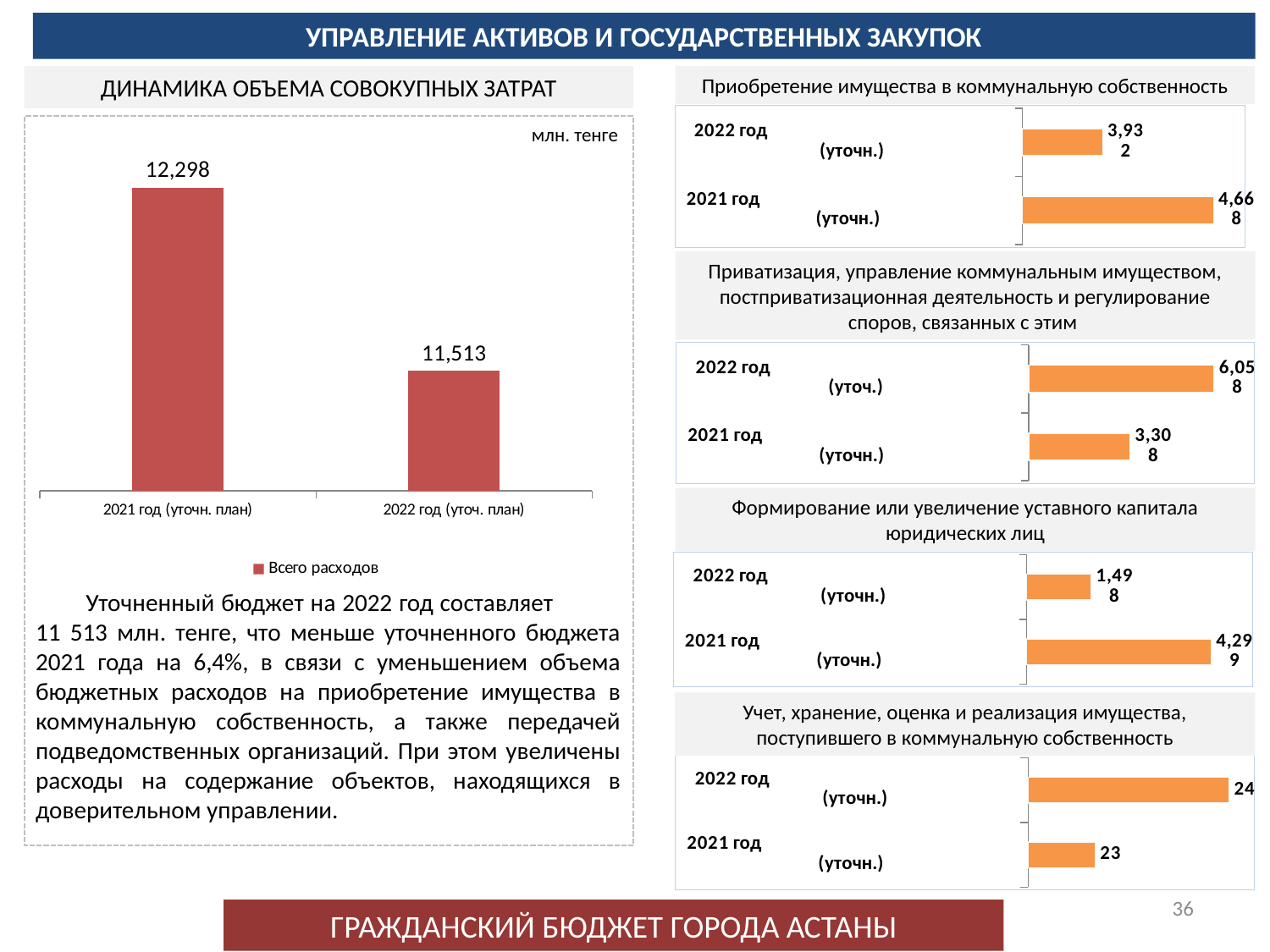
In the chart 'ДИНАМИКА ОБЪЕМА СОВОКУПНЫХ ЗАТРАТ', what is the difference between the 2021 and 2022 values? 785 In the chart 'ДИНАМИКА ОБЪЕМА СОВОКУПНЫХ ЗАТРАТ', what series name does the legend show? Всего расходов In the chart 'Учет, хранение, оценка и реализация имущества, поступившего в коммунальную собственность', what is the value for 2021 год (уточн.)? 23 In the chart 'Приобретение имущества в коммунальную собственность', which year has the larger value, 2021 or 2022? 2021 год (уточн.) In the chart 'ДИНАМИКА ОБЪЕМА СОВОКУПНЫХ ЗАТРАТ', do the values rise or fall from 2021 to 2022? fall In the chart 'ДИНАМИКА ОБЪЕМА СОВОКУПНЫХ ЗАТРАТ', which year has the higher value? 2021 год (уточн. план) In the chart 'ДИНАМИКА ОБЪЕМА СОВОКУПНЫХ ЗАТРАТ', what is the value for 2022 год (уточ. план)? 11,513 In the chart 'Формирование или увеличение уставного капитала юридических лиц', which year has the smaller value? 2022 год (уточн.) In the chart 'ДИНАМИКА ОБЪЕМА СОВОКУПНЫХ ЗАТРАТ', what is the value for 2021 год (уточн. план)? 12,298 In the chart 'Учет, хранение, оценка и реализация имущества, поступившего в коммунальную собственность', what is the value for 2022 год (уточн.)? 24 What kind of chart is 'ДИНАМИКА ОБЪЕМА СОВОКУПНЫХ ЗАТРАТ'? bar chart In the chart 'ДИНАМИКА ОБЪЕМА СОВОКУПНЫХ ЗАТРАТ', what unit is shown in the top right corner? млн. тенге